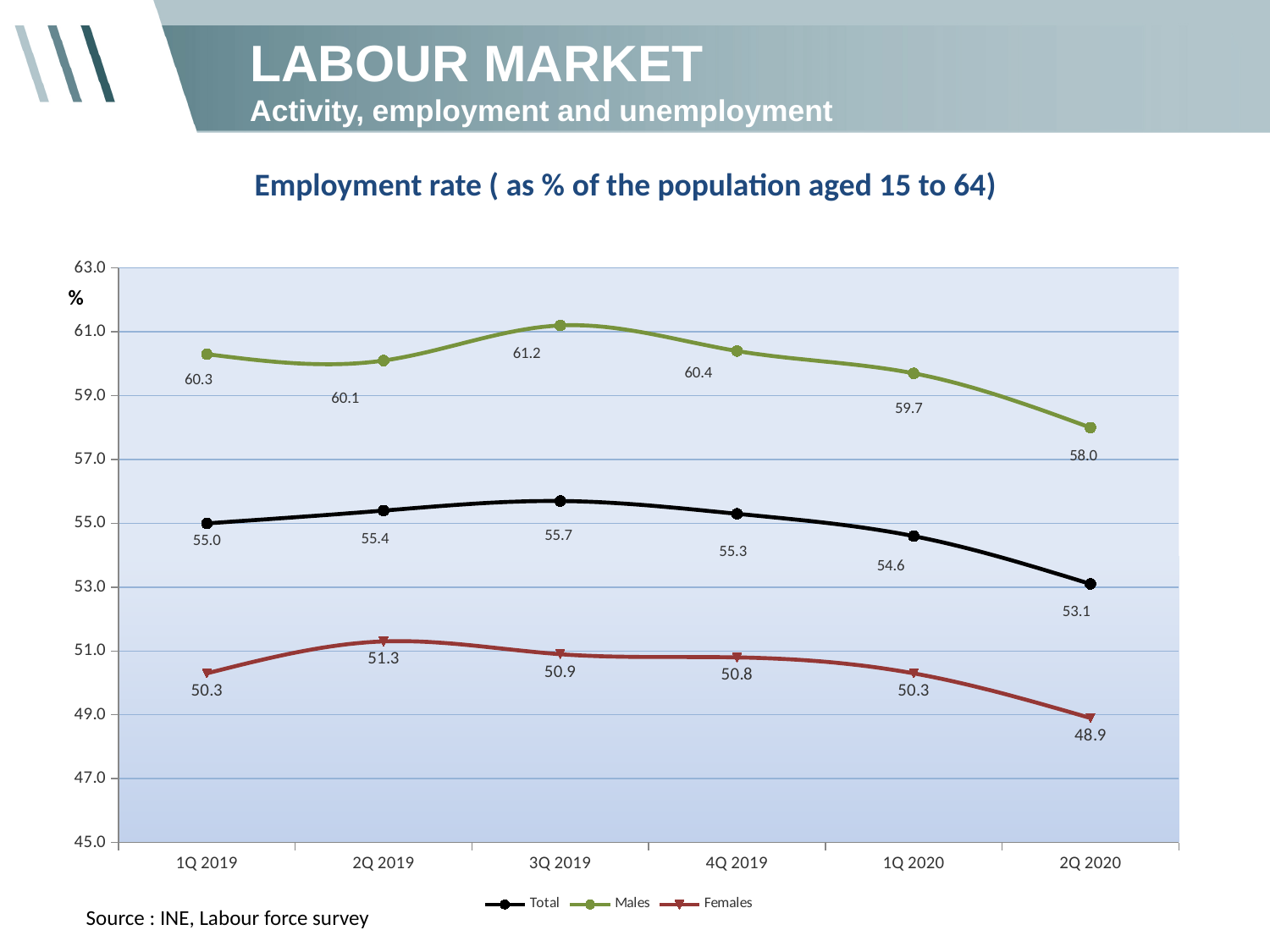
What is the difference between the Males and Females employment rates in 2Q 2020? 9.1 What is the employment rate for Females in 2Q 2020? 48.9 Does the Males employment rate rise or fall from 3Q 2019 to 2Q 2020? Fall In which quarter is the Total employment rate highest? 3Q 2019 How many series does the legend list? 3 What is the employment rate for Males in 3Q 2019? 61.2 Which is larger, the Total employment rate in 2Q 2019 or in 4Q 2019? 2Q 2019 In which quarter is the Females employment rate lowest? 2Q 2020 What is the Total employment rate in 1Q 2020? 54.6 How many quarters are shown on the x axis? 6 What is the title of the chart? Employment rate ( as % of the population aged 15 to 64) What kind of chart is shown on the slide? Line chart